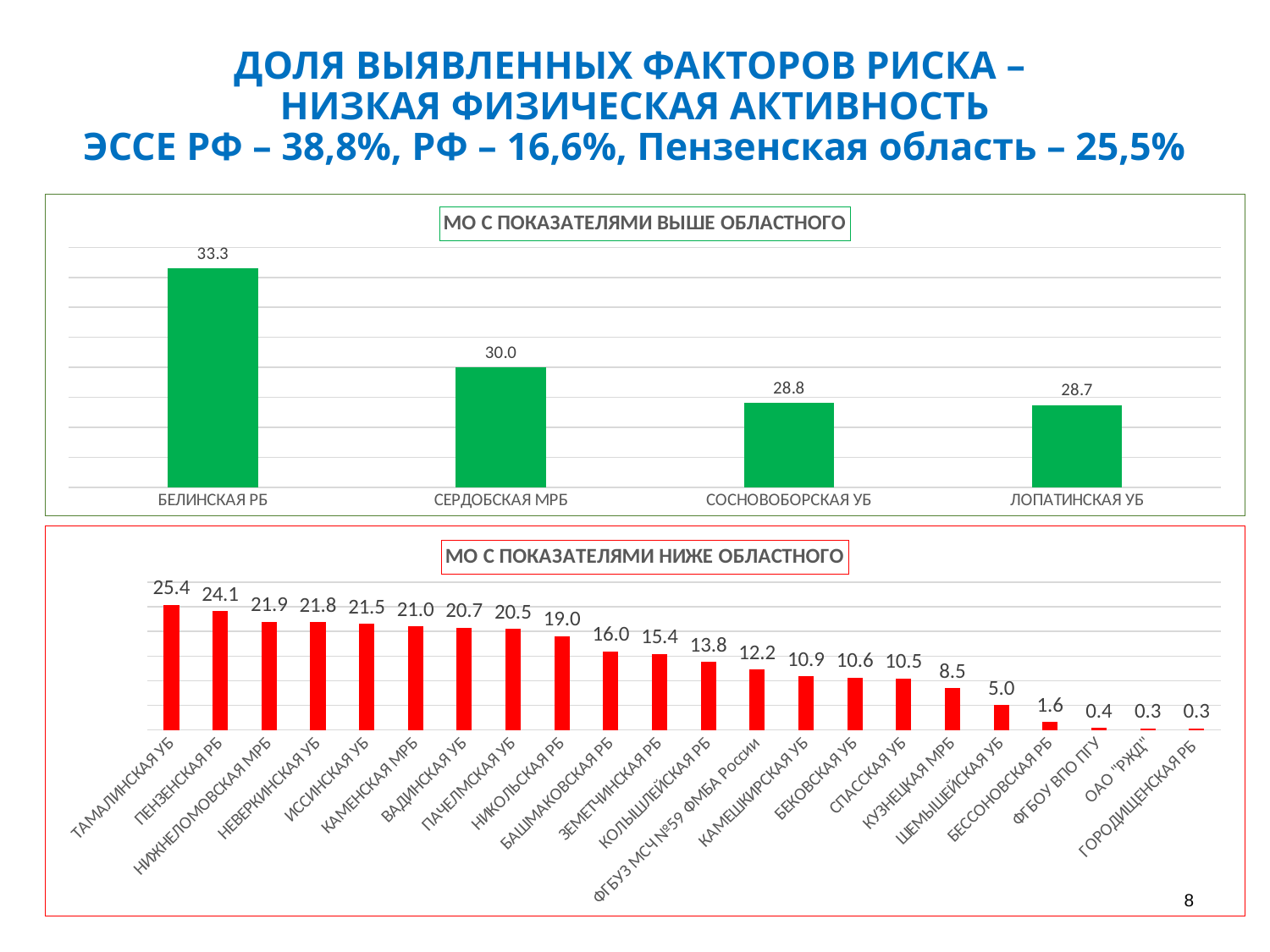
In the top chart (МО С ПОКАЗАТЕЛЯМИ ВЫШЕ ОБЛАСТНОГО), what is the difference between БЕЛИНСКАЯ РБ and СЕРДОБСКАЯ МРБ? 3.3 In the bottom chart (МО С ПОКАЗАТЕЛЯМИ НИЖЕ ОБЛАСТНОГО), what is the value for ШЕМЫШЕЙСКАЯ УБ? 5.0 In the top chart (МО С ПОКАЗАТЕЛЯМИ ВЫШЕ ОБЛАСТНОГО), what is the value for БЕЛИНСКАЯ РБ? 33.3 In the bottom chart (МО С ПОКАЗАТЕЛЯМИ НИЖЕ ОБЛАСТНОГО), which category has the highest value? ТАМАЛИНСКАЯ УБ In the top chart (МО С ПОКАЗАТЕЛЯМИ ВЫШЕ ОБЛАСТНОГО), which category has the lowest value? ЛОПАТИНСКАЯ УБ In the top chart (МО С ПОКАЗАТЕЛЯМИ ВЫШЕ ОБЛАСТНОГО), how many categories are shown? 4 In the bottom chart (МО С ПОКАЗАТЕЛЯМИ НИЖЕ ОБЛАСТНОГО), which is larger: ПЕНЗЕНСКАЯ РБ or НИКОЛЬСКАЯ РБ? ПЕНЗЕНСКАЯ РБ In the bottom chart (МО С ПОКАЗАТЕЛЯМИ НИЖЕ ОБЛАСТНОГО), how many categories are shown? 22 In the bottom chart (МО С ПОКАЗАТЕЛЯМИ НИЖЕ ОБЛАСТНОГО), what is the value for КОЛЫШЛЕЙСКАЯ РБ? 13.8 In the bottom chart (МО С ПОКАЗАТЕЛЯМИ НИЖЕ ОБЛАСТНОГО), do the values rise or fall from left to right? Fall In the bottom chart (МО С ПОКАЗАТЕЛЯМИ НИЖЕ ОБЛАСТНОГО), what is the difference between ТАМАЛИНСКАЯ УБ and ПЕНЗЕНСКАЯ РБ? 1.3 In the top chart (МО С ПОКАЗАТЕЛЯМИ ВЫШЕ ОБЛАСТНОГО), what kind of chart is it? Bar chart